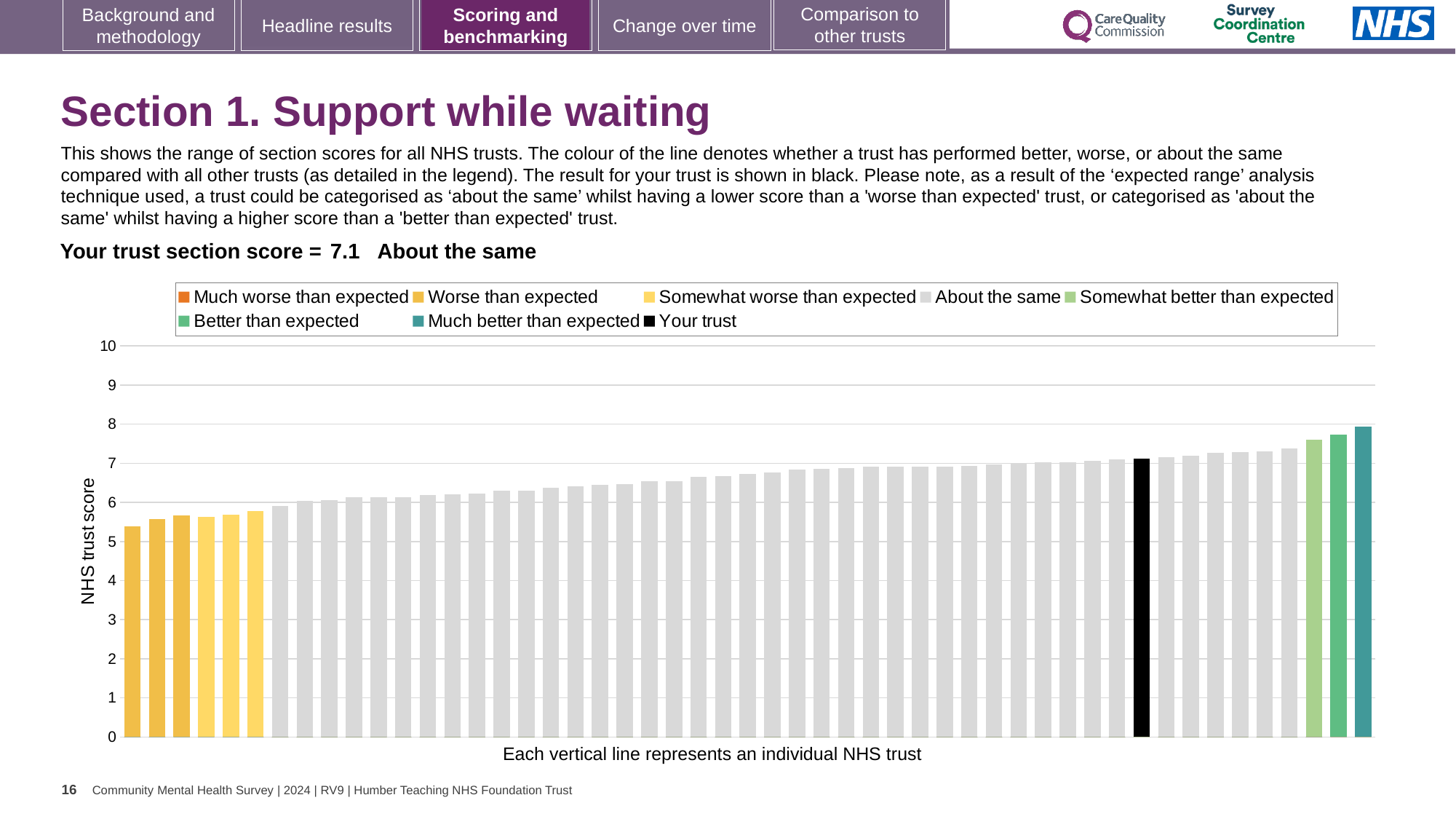
What kind of chart is shown on the slide? Bar chart Is the value of the lowest bar in the chart greater or less than 6? less How many bars are coloured as 'Worse than expected' (yellow)? 3 How many entries does the chart legend list? 8 Which category is your trust placed in according to the slide? About the same What is the label of the y axis? NHS trust score Do the bar values rise or fall from left to right along the x axis? rise How many bars are coloured as 'Much better than expected' (teal)? 1 Is the value for your trust (the black bar) greater or less than 7? greater Is the value of the highest bar in the chart greater or less than 7? greater What is the section score for your trust shown on the slide? 7.1